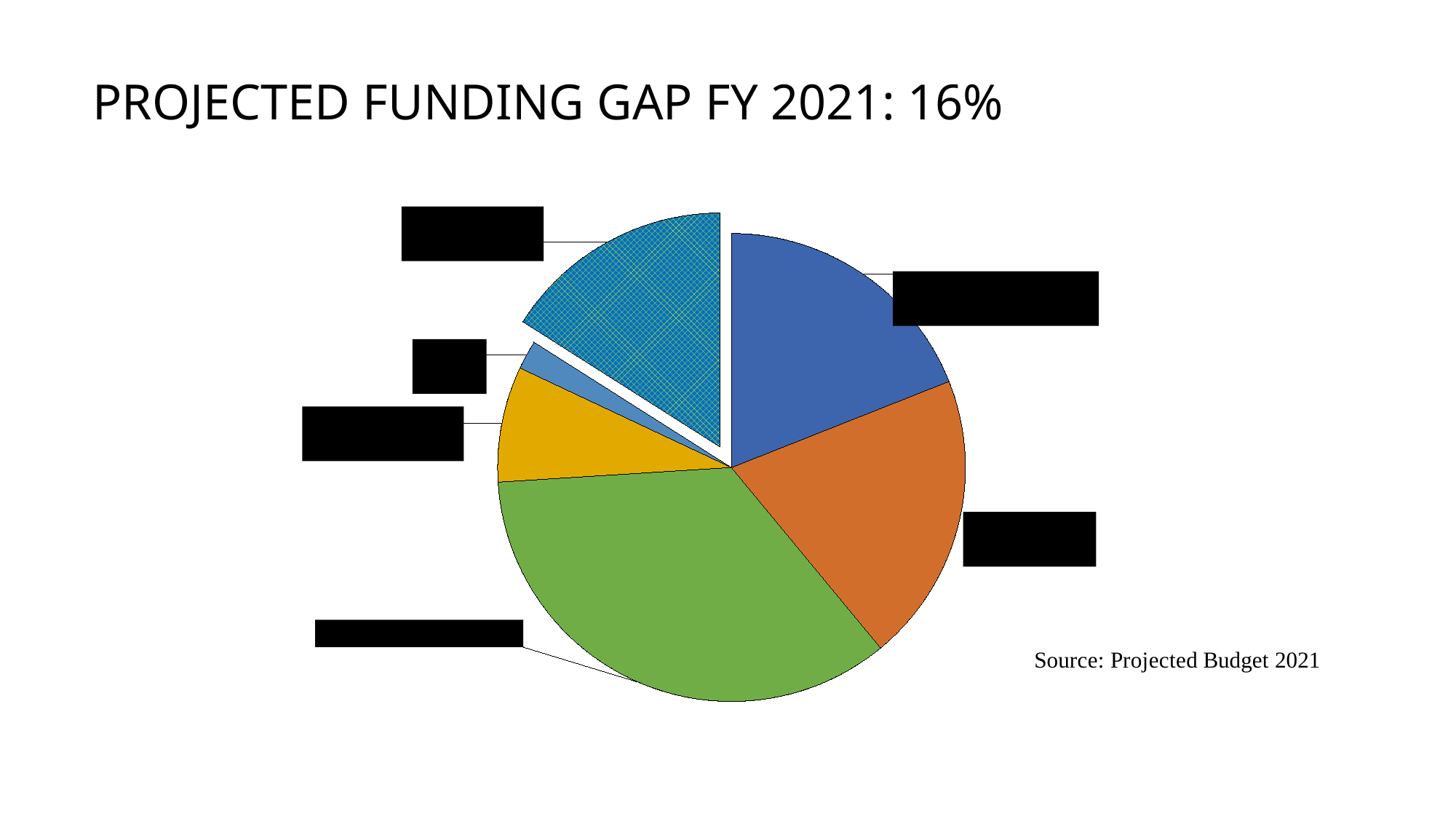
Which is larger, the green slice or the orange slice? green How many slices does the pie chart have? 6 Which colour slice is the largest in the pie chart? green Which is larger, the patterned blue slice or the light blue slice? patterned blue What is the title of the slide? PROJECTED FUNDING GAP FY 2021: 16% Which slice is pulled out (exploded) from the pie chart? the patterned blue slice Which colour slice is the smallest in the pie chart? light blue Which is larger, the orange slice or the yellow slice? orange What kind of chart is shown on the slide? pie chart